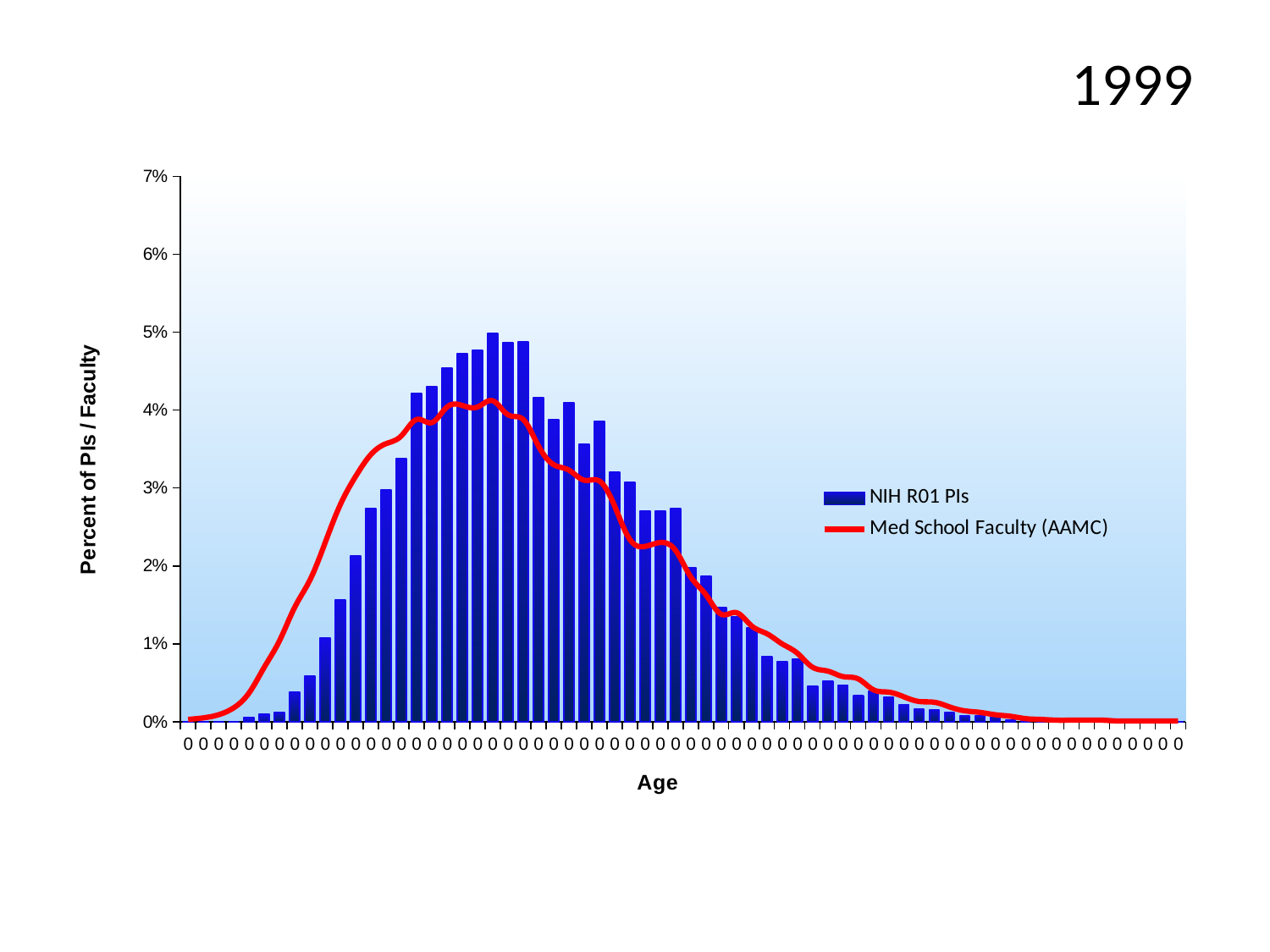
Is the tallest NIH R01 PIs bar greater or less than 4%? greater Which series is drawn as blue bars? NIH R01 PIs Which series reaches a higher peak value, NIH R01 PIs or Med School Faculty (AAMC)? NIH R01 PIs Is the peak of the Med School Faculty (AAMC) line greater or less than 3%? greater What kind of chart is shown on the slide? A bar chart with a line overlay What is the label on the x axis? Age Is the tallest NIH R01 PIs bar greater or less than 6%? less How many series does the legend list? 2 Toward the right end of the x axis, do the NIH R01 PIs bars rise or fall? fall